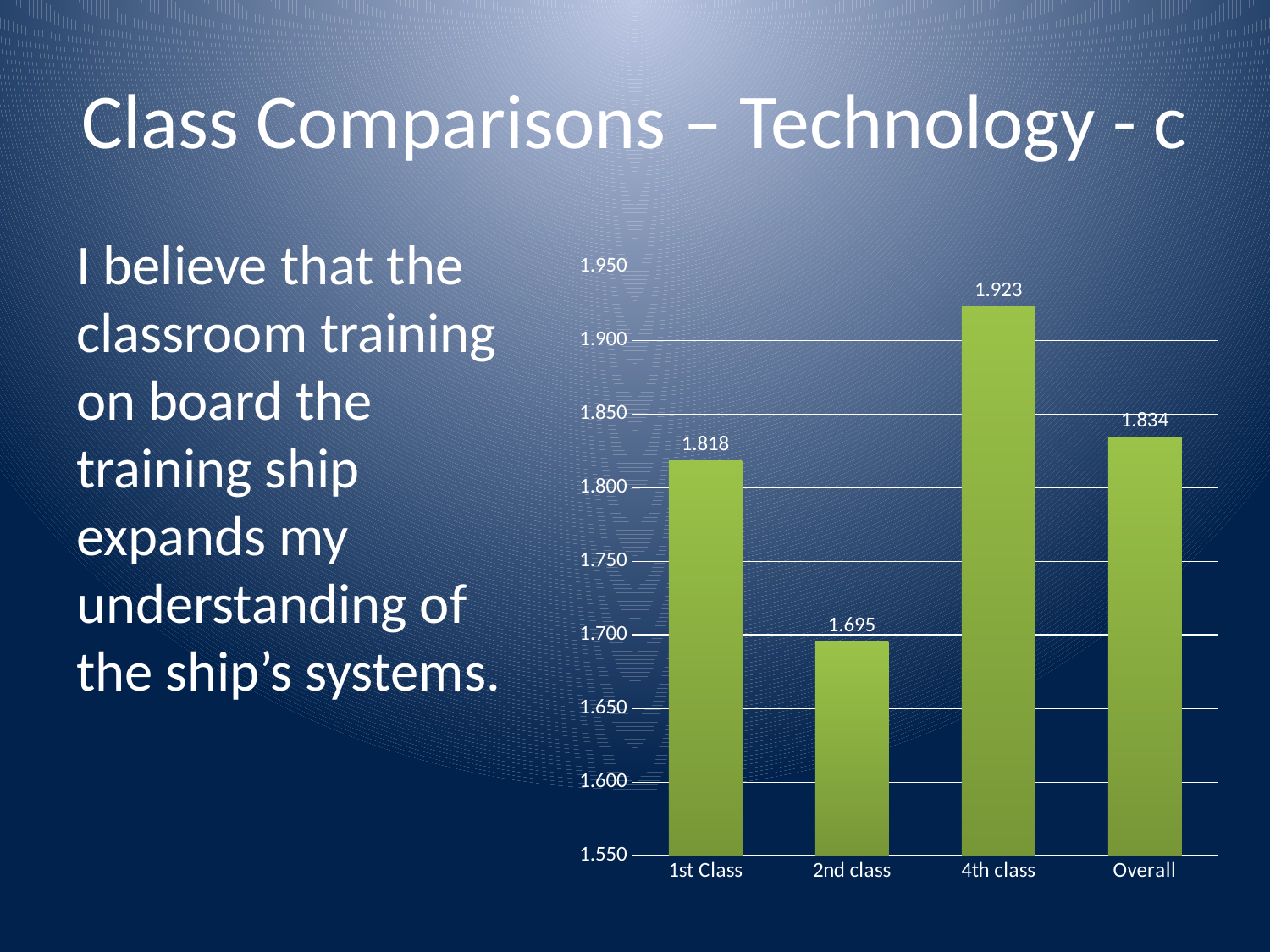
What is the difference between the values for Overall and 1st Class? 0.016 What is the difference between the values for 4th class and 2nd class? 0.228 How many categories are shown on the x axis? 4 Is the value for 2nd class greater or less than 1.700? less What kind of chart is shown on the slide? bar chart Which category has the highest value? 4th class What is the value for 1st Class? 1.818 Which category has the lowest value? 2nd class Which is larger, the value for 1st Class or the value for 2nd class? 1st Class What is the value for 4th class? 1.923 What is the value for 2nd class? 1.695 What is the value for Overall? 1.834